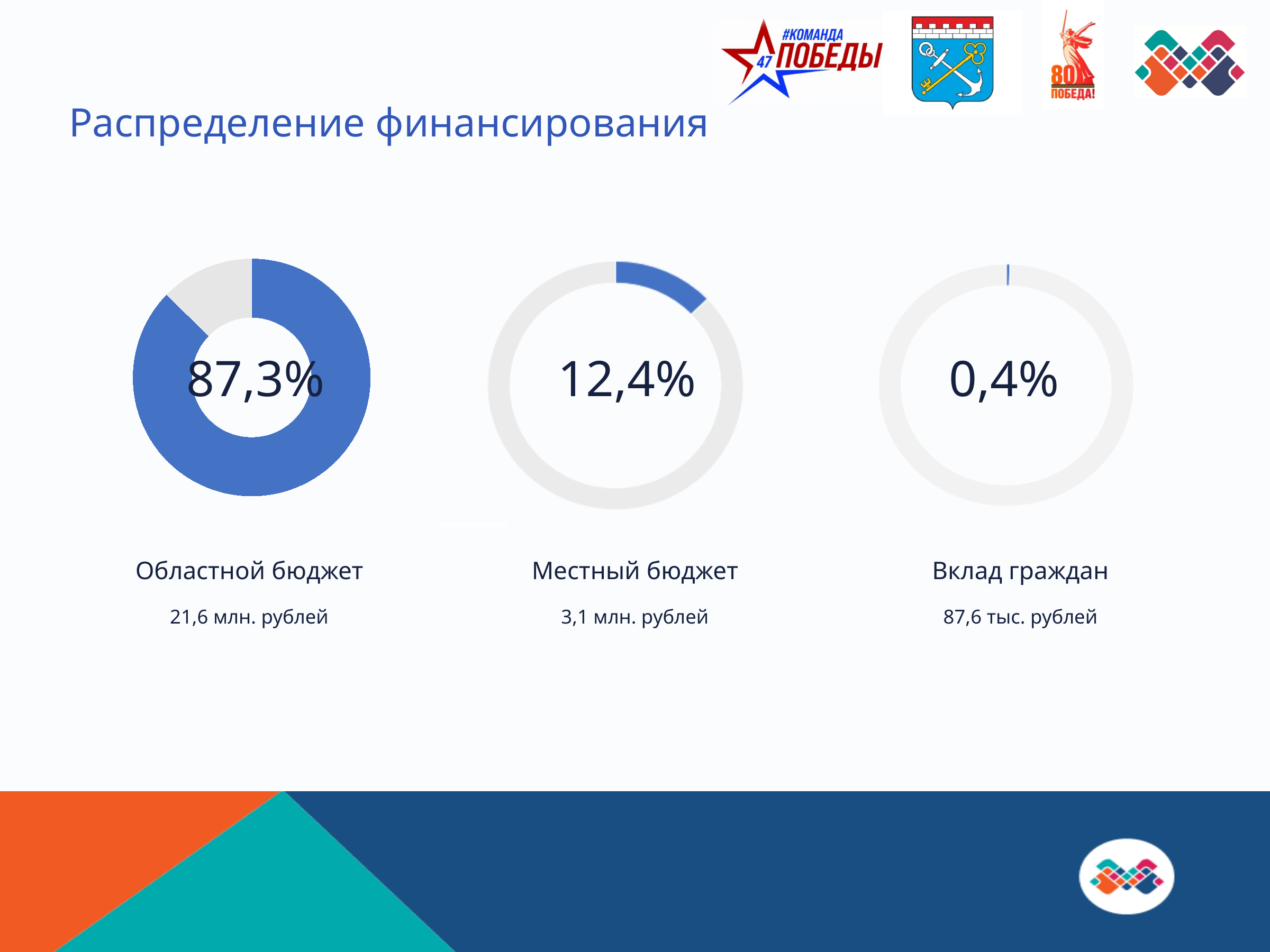
How many donut charts are shown on the slide? 3 What is the difference in percentage points between the Областной бюджет share and the Местный бюджет share? 74,9 Which share is larger: Местный бюджет or Вклад граждан? Местный бюджет What percentage is shown in the donut chart for Вклад граждан? 0,4% What is the title of the slide containing the three donut charts? Распределение финансирования Which funding source has the largest share among the three donut charts? Областной бюджет What amount in rubles is given under the Областной бюджет chart? 21,6 млн. рублей What percentage is shown in the donut chart for Местный бюджет? 12,4% What amount in rubles is given under the Вклад граждан chart? 87,6 тыс. рублей What amount in rubles is given under the Местный бюджет chart? 3,1 млн. рублей What percentage is shown in the donut chart for Областной бюджет? 87,3% Which funding source has the smallest share among the three donut charts? Вклад граждан